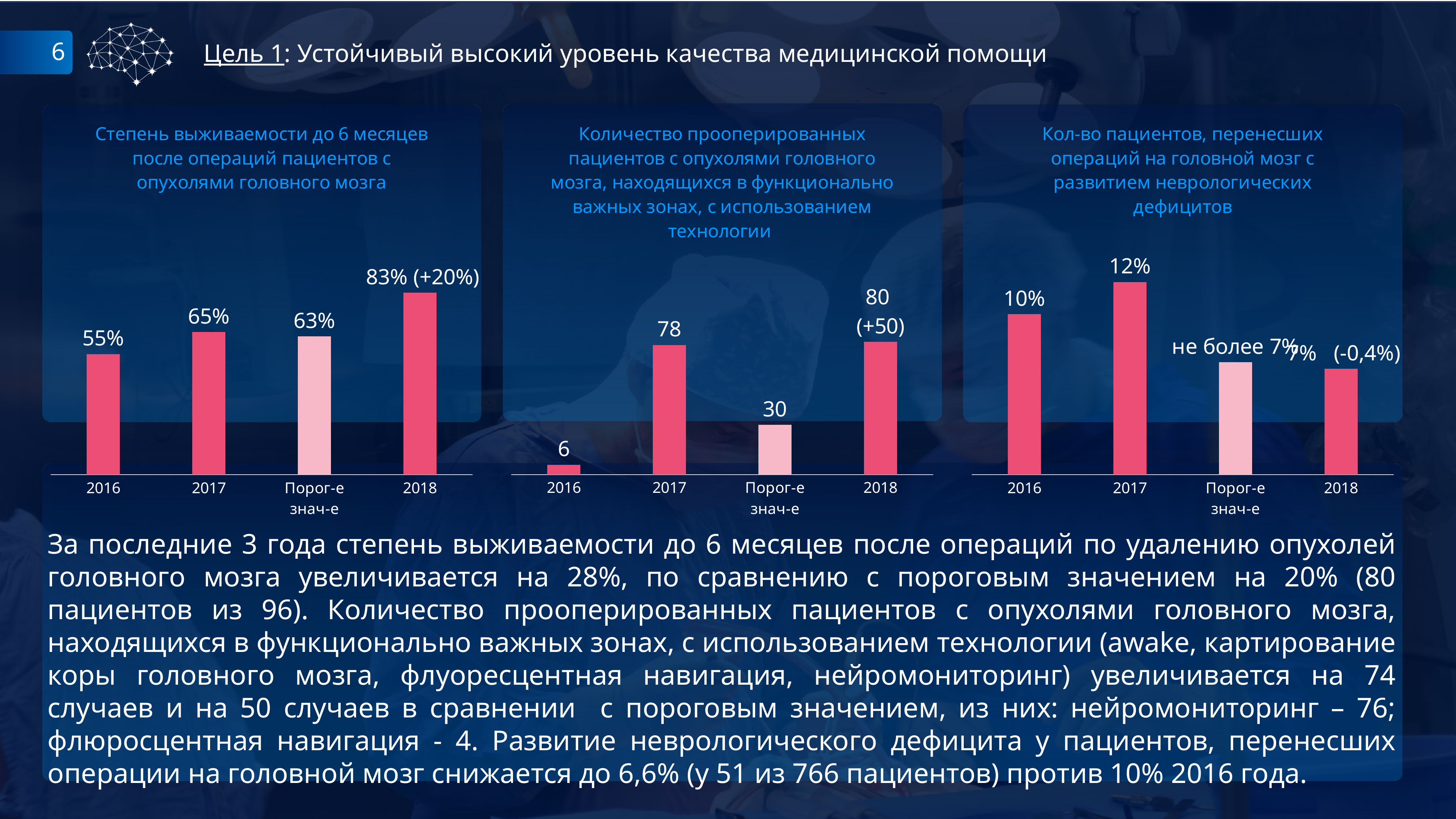
In the left chart (survival rate up to 6 months), what is the value for 2016? 55% How many bars does the left chart (survival rate up to 6 months) have? 4 In the middle chart (number of operated patients using technology), what is the difference between the 2018 and 2017 values? 2 In the left chart (survival rate up to 6 months), what is the difference between the 2018 value and the threshold value (Порог-е знач-е)? 20% In the right chart (patients with neurological deficits), which is larger: the value for 2016 or the value for 2018? 2016 In the middle chart (number of operated patients using technology), what is the value for 2016? 6 In the middle chart (number of operated patients using technology), what is the threshold value (Порог-е знач-е)? 30 In the middle chart (number of operated patients using technology), which category has the lowest value? 2016 In the right chart (patients with neurological deficits), what is the value for 2017? 12% In the left chart (survival rate up to 6 months), which category has the highest value? 2018 What type of chart is the middle chart (number of operated patients using technology)? Bar chart In the left chart (survival rate up to 6 months), what is the value for 2018? 83%